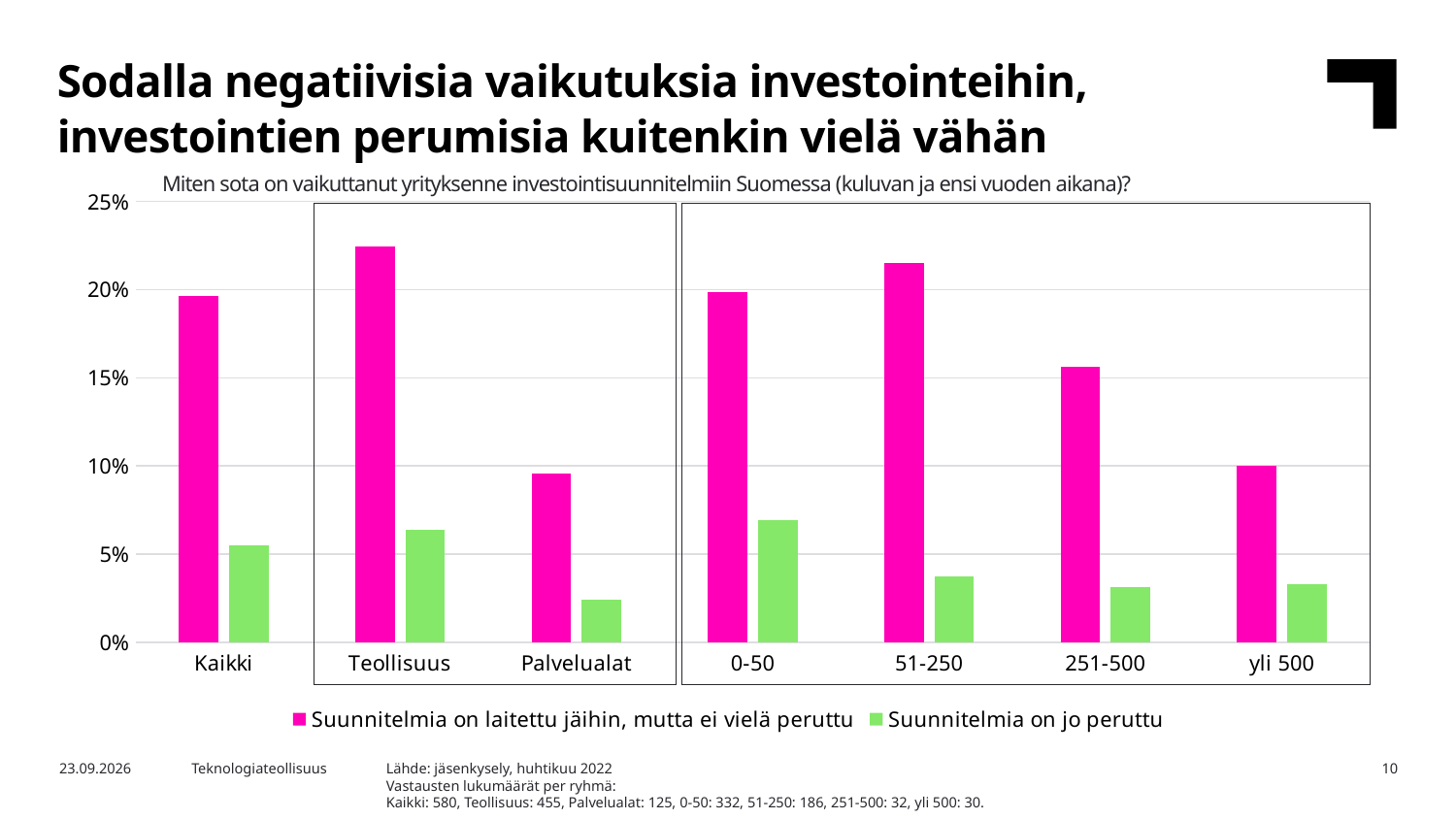
How many series does the legend list? 2 Which is larger for 'Suunnitelmia on jo peruttu': Teollisuus or 51-250? Teollisuus What colour are the bars for the series 'Suunnitelmia on jo peruttu'? green Which is larger for 'Suunnitelmia on laitettu jäihin, mutta ei vielä peruttu': Kaikki or Palvelualat? Kaikki Which category has the highest value for 'Suunnitelmia on laitettu jäihin, mutta ei vielä peruttu'? Teollisuus Is the value for Teollisuus in the series 'Suunnitelmia on laitettu jäihin, mutta ei vielä peruttu' greater or less than 20%? greater Is the value for 0-50 in the series 'Suunnitelmia on jo peruttu' greater or less than 5%? greater What kind of chart is shown on the slide? bar chart How many categories are shown on the x axis? 7 Which category has the lowest value for 'Suunnitelmia on jo peruttu'? Palvelualat Is the value for 251-500 in the series 'Suunnitelmia on laitettu jäihin, mutta ei vielä peruttu' greater or less than 15%? greater